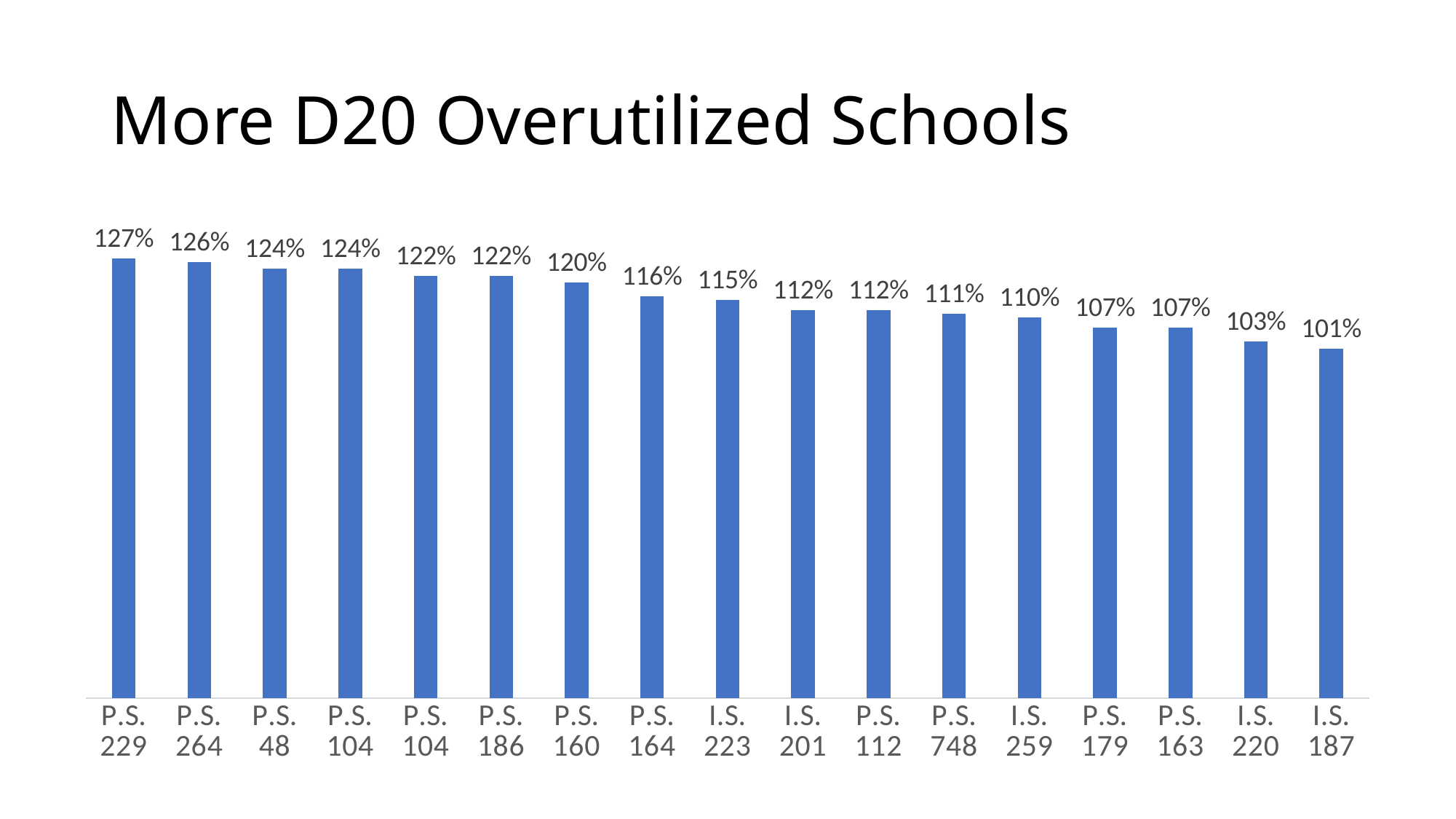
What is the title of the slide? More D20 Overutilized Schools What kind of chart is shown on the slide? Bar chart Which school has the lowest value? I.S. 187 What is the difference between the values for P.S. 160 and I.S. 259? 10% What is the value for I.S. 187? 101% What is the value for I.S. 223? 115% What is the value for P.S. 229? 127% Which school has the highest value? P.S. 229 How many schools are shown in the chart? 17 Which is larger, the value for P.S. 264 or the value for P.S. 164? P.S. 264 What is the difference between the values for P.S. 229 and I.S. 187? 26% What is the value for P.S. 748? 111%